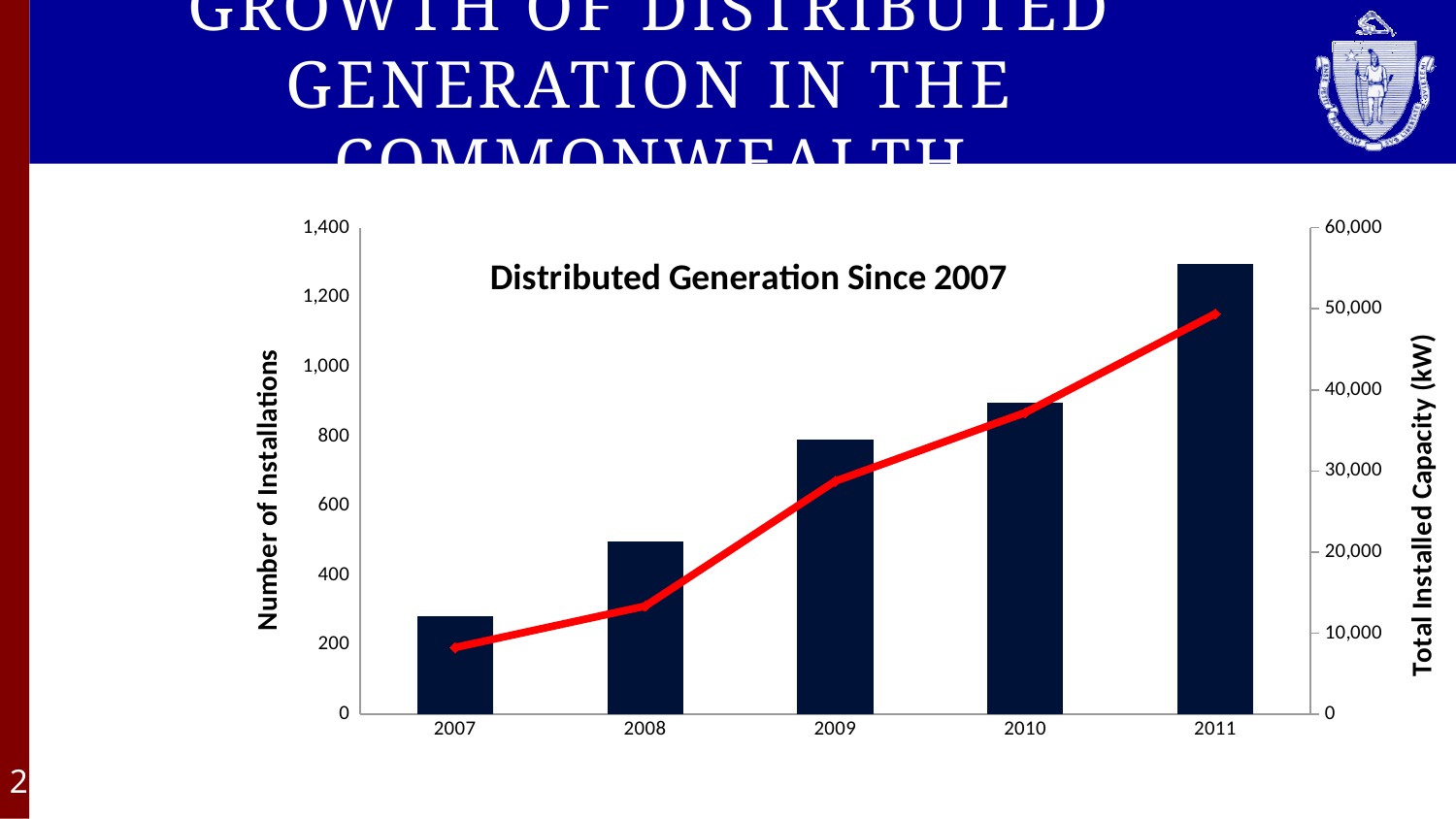
What is the label of the right-hand vertical axis? Total Installed Capacity (kW) Is the number of installations in 2007 greater or less than 400? less What kind of chart is shown on the slide? A combined bar and line chart Is the total installed capacity in 2008 greater or less than 20,000 kW? less Is the total installed capacity in 2011 greater or less than 40,000 kW? greater Do the number of installations rise or fall from 2007 to 2011? Rise What is the title of the chart? Distributed Generation Since 2007 Which year has more installations, 2008 or 2009? 2009 Which year has the lowest number of installations? 2007 Which year has the highest number of installations? 2011 How many years are shown on the x axis of the chart? 5